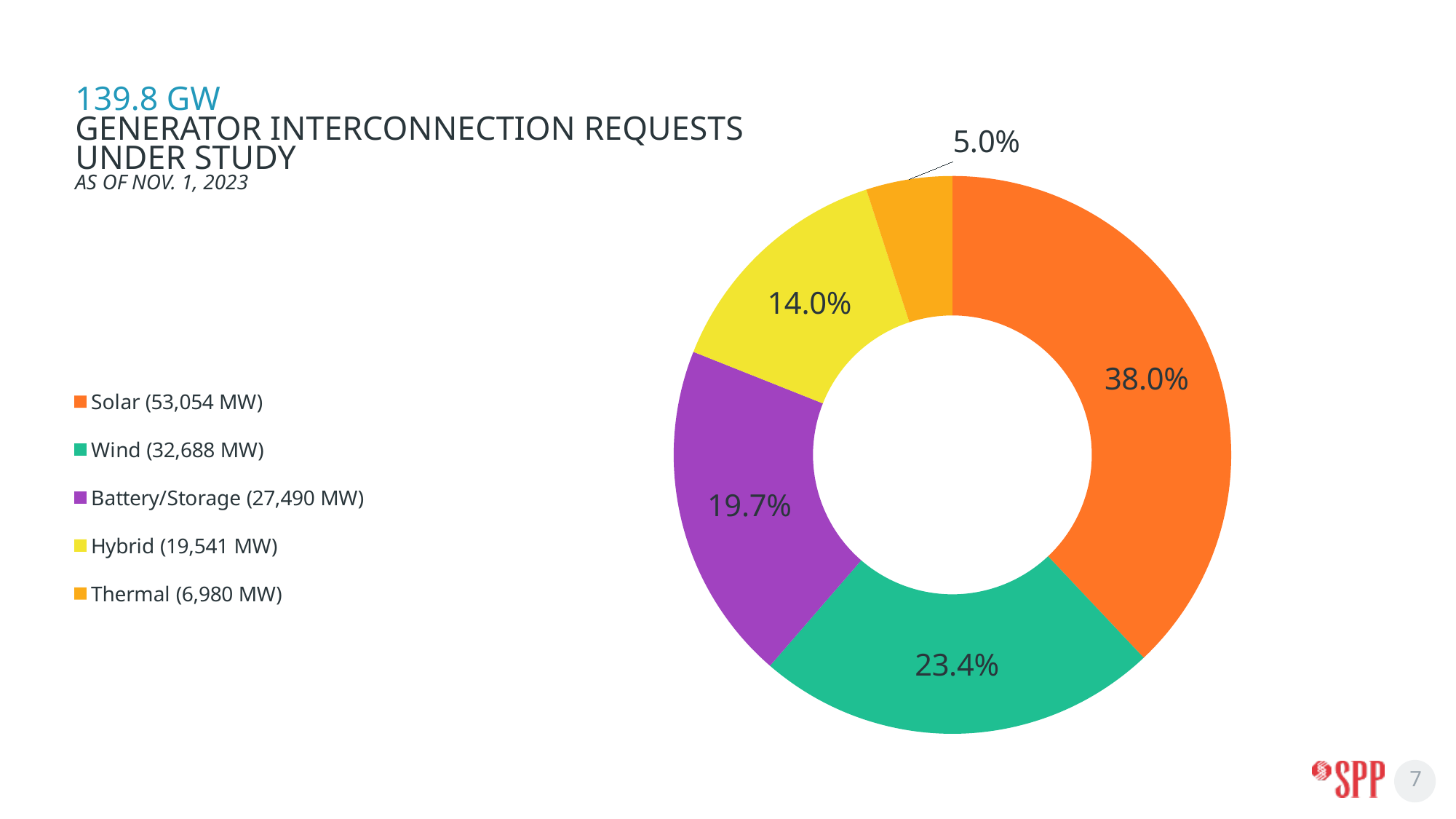
How many categories are shown in the chart? 5 Which category has the largest share of the generator interconnection requests under study? Solar What share of the generator interconnection requests under study is Wind? 23.4% What share of the generator interconnection requests under study is Solar? 38.0% What share of the generator interconnection requests under study is Thermal? 5.0% What is the difference in percentage points between the Solar share and the Wind share? 14.6 percentage points How many MW of Battery/Storage requests are under study according to the legend? 27,490 MW Which category has the smallest share of the generator interconnection requests under study? Thermal How many MW of Wind requests are under study according to the legend? 32,688 MW What kind of chart is shown on the slide? Pie chart (doughnut)